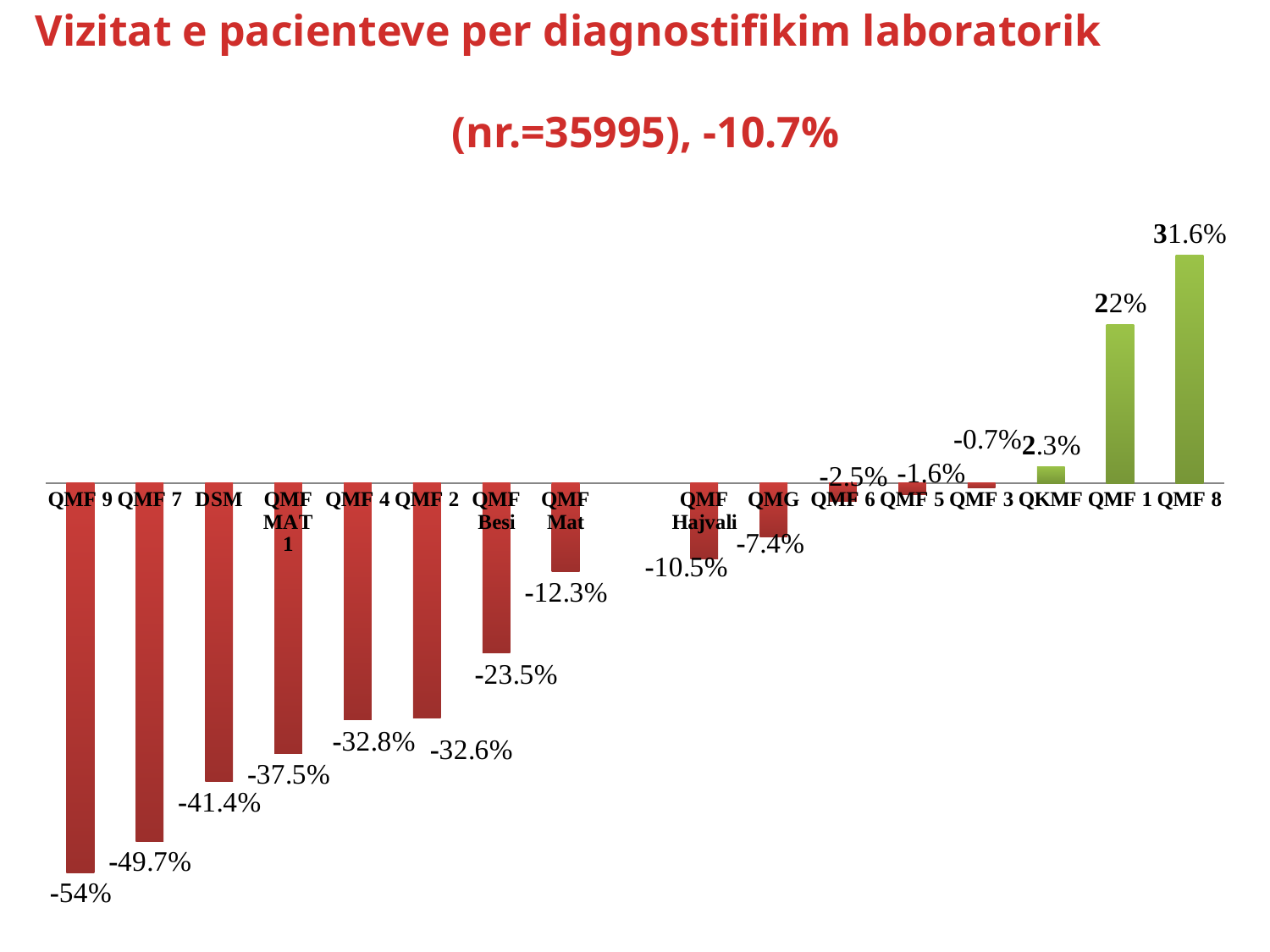
What is the difference between the values for QMF 1 and QKMF? 19.7 percentage points Which category has the highest value? QMF 8 What is the value for QMF 8? 31.6% What overall percentage change is stated in the chart title? -10.7% Do the values generally rise or fall from left to right along the x axis? Rise What is the value for QMF Hajvali? -10.5% What is the value for QMF 9? -54% What is the value for QMG? -7.4% Which has the larger value, DSM or QMF Besi? QMF Besi What kind of chart is shown on the slide? Bar chart Which category has the lowest value? QMF 9 How many bars have a positive value? 3